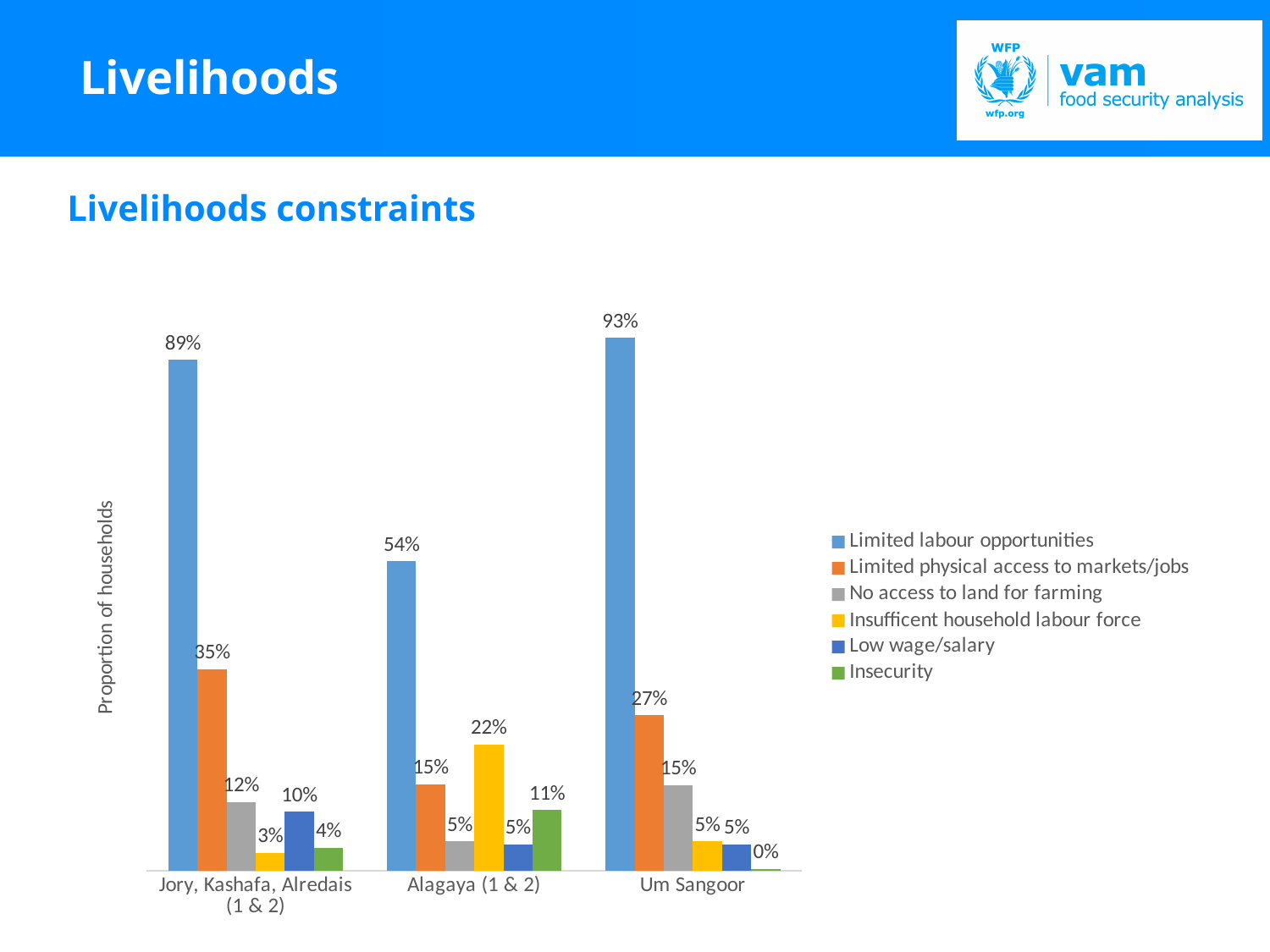
Which location has the highest value for Limited labour opportunities? Um Sangoor How many series does the legend list? 6 What is the difference between the Limited labour opportunities values for Um Sangoor and Jory, Kashafa, Alredais (1 & 2)? 4% What is the value for Insufficent household labour force in Alagaya (1 & 2)? 22% What is the label on the vertical axis? Proportion of households What proportion of households in Um Sangoor report limited labour opportunities? 93% Which location has the lowest value for Limited labour opportunities? Alagaya (1 & 2) What is the value for Insecurity in Um Sangoor? 0% What kind of chart is shown on the slide? Bar chart Which is larger: Limited physical access to markets/jobs in Jory, Kashafa, Alredais (1 & 2) or in Um Sangoor? Jory, Kashafa, Alredais (1 & 2) How many locations are shown on the x axis? 3 What is the value for Limited physical access to markets/jobs in Jory, Kashafa, Alredais (1 & 2)? 35%